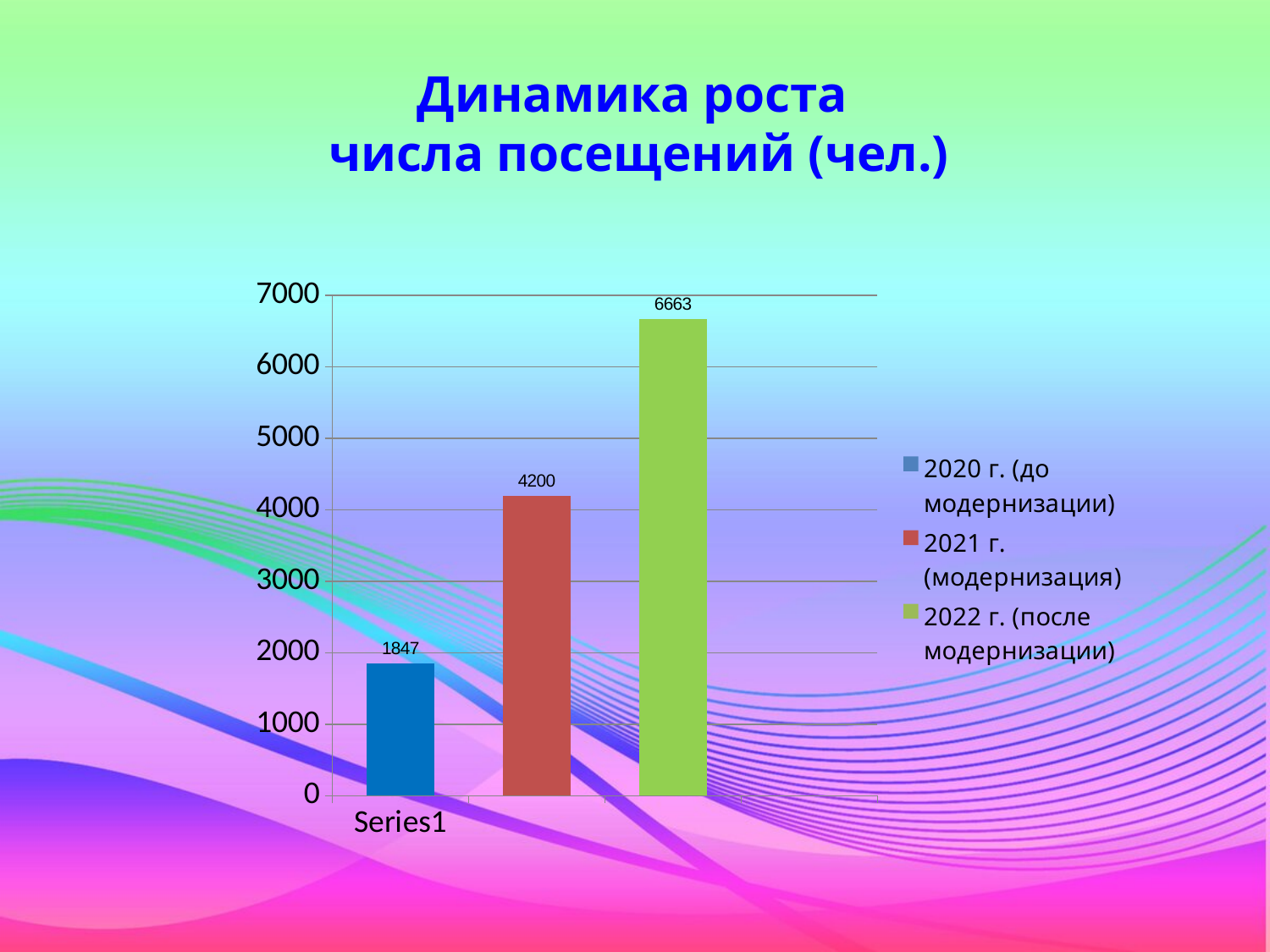
What is the title of the chart on the slide? Динамика роста числа посещений (чел.) Is the value for 2021 г. (модернизация) greater or less than 5000? less Which series has the highest value? 2022 г. (после модернизации) What is the difference between the values for 2021 г. (модернизация) and 2020 г. (до модернизации)? 2353 How many series does the legend list? 3 Which is larger, the value for 2021 г. (модернизация) or the value for 2022 г. (после модернизации)? 2022 г. (после модернизации) What is the value for 2022 г. (после модернизации)? 6663 What is the difference between the values for 2022 г. (после модернизации) and 2020 г. (до модернизации)? 4816 Which series has the lowest value? 2020 г. (до модернизации) What kind of chart is shown on the slide? bar chart What is the value for 2020 г. (до модернизации)? 1847 What is the value for 2021 г. (модернизация)? 4200